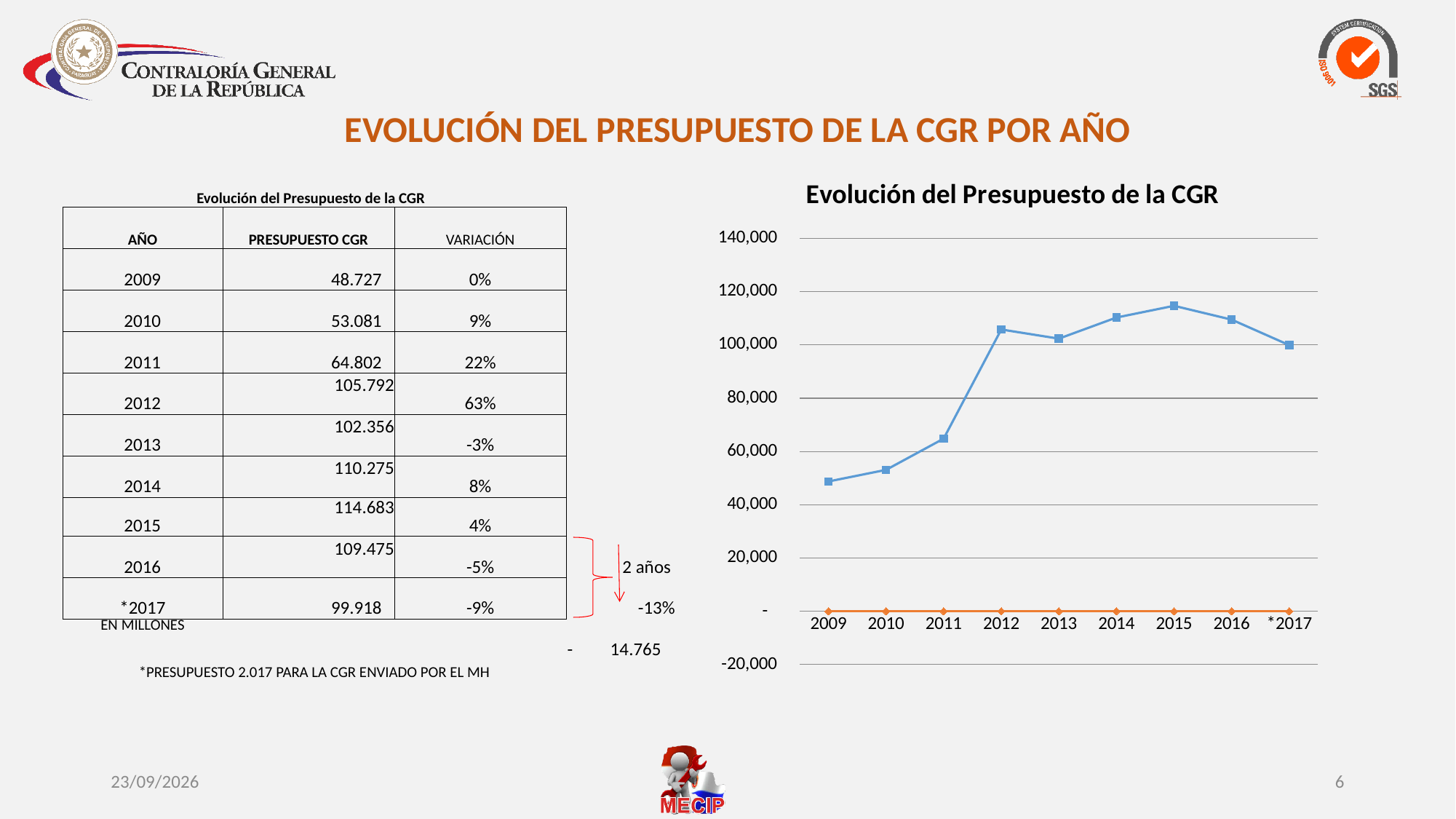
Is the value of the blue line for 2015 greater or less than 120,000? less In which year does the blue line have its lowest value? 2009 Is the value of the blue line for 2010 greater or less than 60,000? less How many years are shown on the x axis of the chart? 9 Is the value of the blue line for 2009 greater or less than 40,000? greater In which year does the blue line reach its highest point? 2015 Does the blue line rise or fall between 2015 and *2017? fall Does the blue line rise or fall between 2009 and 2012? rise What is the title of the chart on the slide? Evolución del Presupuesto de la CGR What kind of chart is shown on the slide? line chart Which year has the larger value on the blue line, 2011 or 2014? 2014